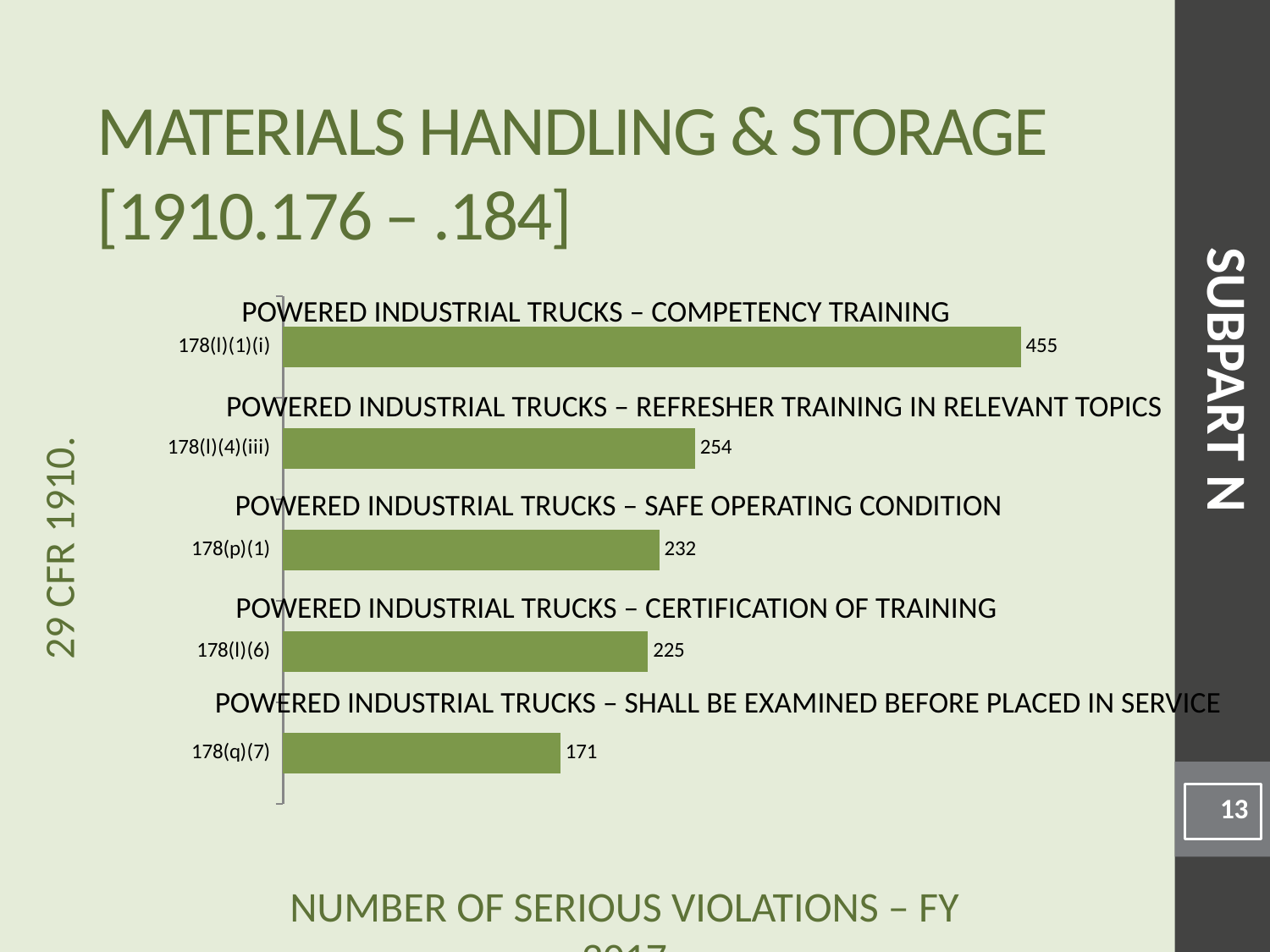
What is the number of serious violations for 178(l)(1)(i), Powered Industrial Trucks – Competency Training? 455 What kind of chart is shown on the slide? Bar chart Which standard has the lowest number of serious violations? 178(q)(7) What is the number of serious violations for 178(q)(7), Powered Industrial Trucks – Shall Be Examined Before Placed in Service? 171 What is the number of serious violations for 178(p)(1), Powered Industrial Trucks – Safe Operating Condition? 232 What is the difference in serious violations between 178(l)(1)(i) and 178(l)(4)(iii)? 201 Which standard has the highest number of serious violations? 178(l)(1)(i) Which has more serious violations, 178(p)(1) or 178(l)(6)? 178(p)(1) How many standards are shown in the chart? 5 What is the number of serious violations for 178(l)(4)(iii), Powered Industrial Trucks – Refresher Training in Relevant Topics? 254 What is the difference in serious violations between 178(l)(6) and 178(q)(7)? 54 What is the total number of serious violations across all five standards shown? 1337